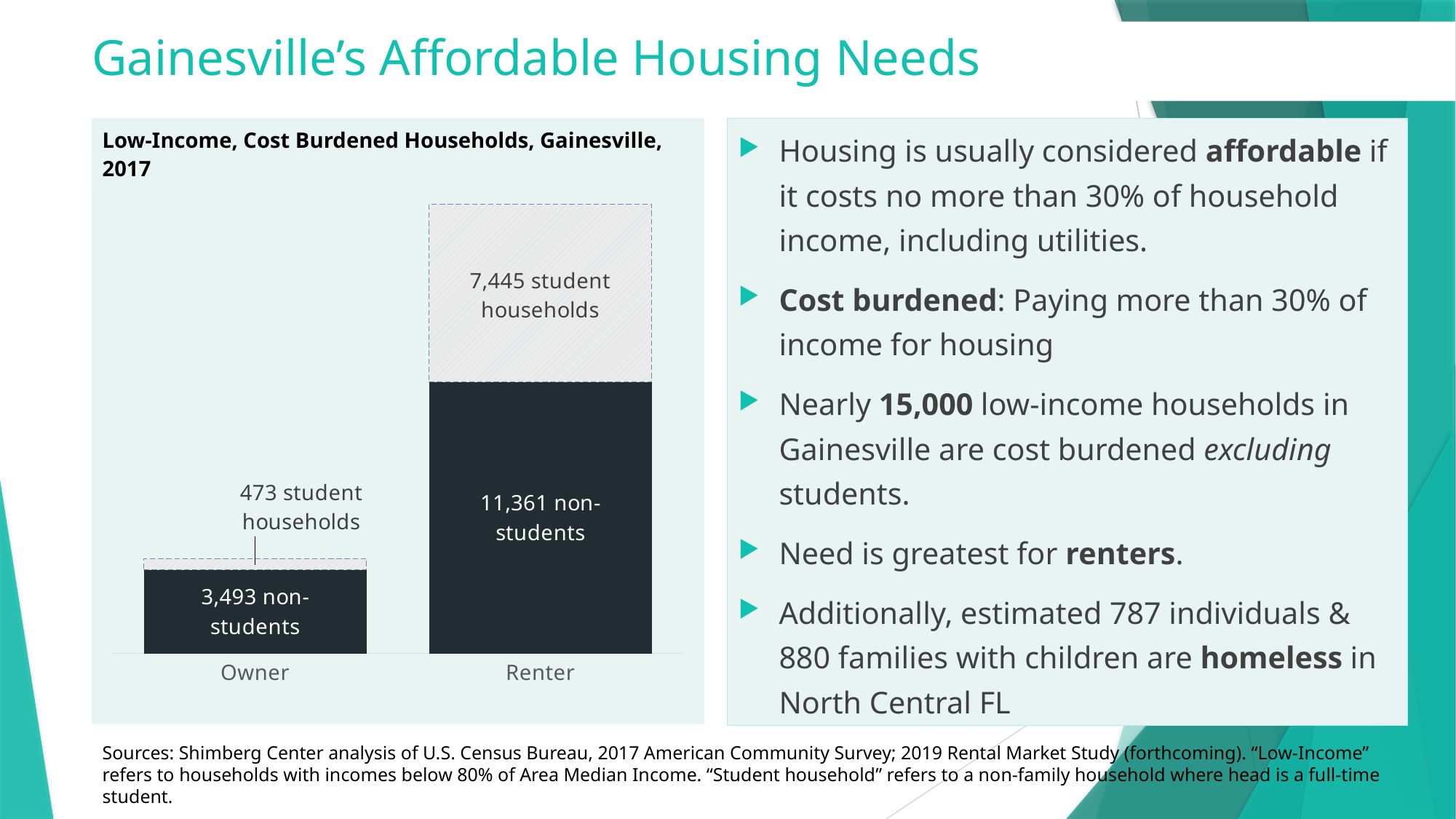
How many non-student households are shown for Owner? 3,493 How many student households are shown for Renter? 7,445 Which is larger, the number of student households for Renter or the number of non-student households for Owner? Student households for Renter What is the total number of households in the Owner bar? 3,966 How many non-student households are shown for Renter? 11,361 Which category has the taller stacked bar, Owner or Renter? Renter How many student households are shown for Owner? 473 What kind of chart is shown on the slide? Stacked bar chart How many categories are shown on the x axis of the chart? 2 What is the title of the chart? Low-Income, Cost Burdened Households, Gainesville, 2017 What is the difference between the non-student households for Renter and for Owner? 7,868 What is the total number of households in the Renter bar? 18,806